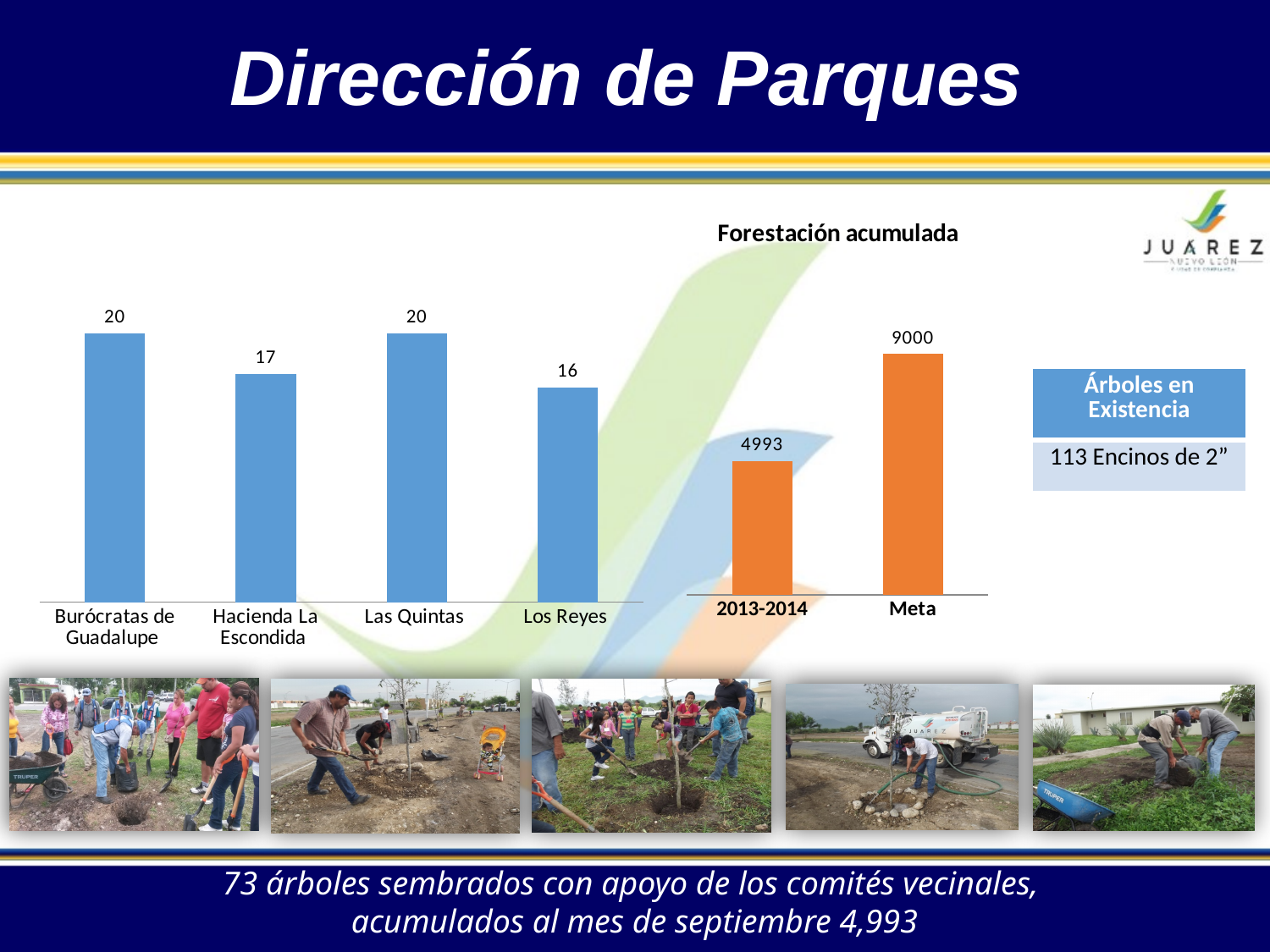
In the Forestación acumulada chart, what is the value for Meta? 9000 How many categories are shown in the left bar chart? 4 In the Forestación acumulada chart, what is the value for 2013-2014? 4993 In the left bar chart, what is the value for Hacienda La Escondida? 17 In the Forestación acumulada chart, which category has the highest value? Meta In the left bar chart, which is larger, Hacienda La Escondida or Los Reyes? Hacienda La Escondida What is the title of the chart on the right? Forestación acumulada In the left bar chart, what is the value for Los Reyes? 16 In the Forestación acumulada chart, what is the difference between Meta and 2013-2014? 4007 In the left bar chart, which category has the lowest value? Los Reyes In the left bar chart, what is the difference between Burócratas de Guadalupe and Los Reyes? 4 What type of chart is the left chart? bar chart